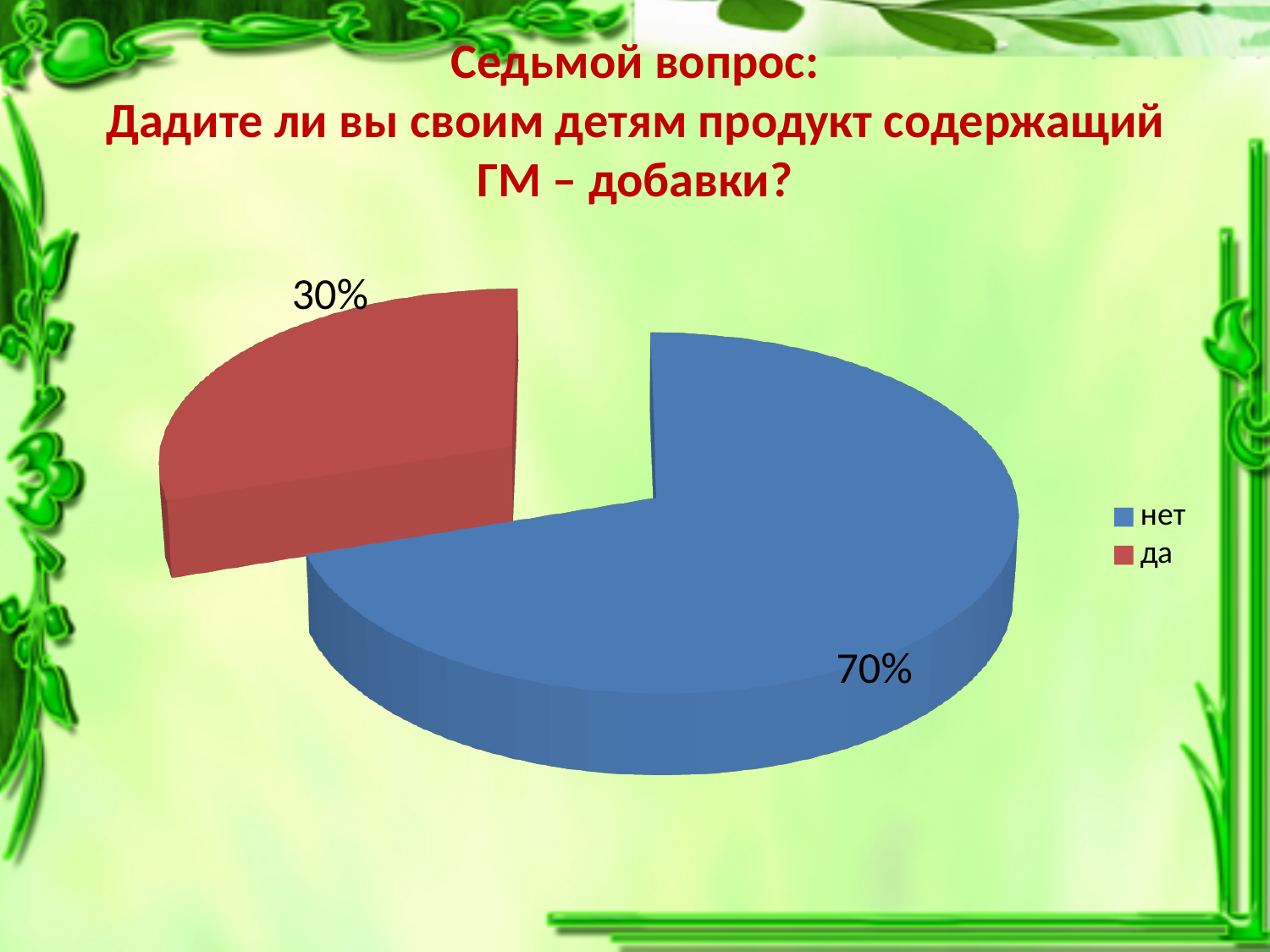
What colour is the slice for "нет"? blue What percentage is shown for "да"? 30% What colour is the slice for "да"? red Which is larger, the share for "да" or the share for "нет"? нет What percentage is shown for "нет"? 70% How many entries does the legend list? 2 What share of the pie does the "нет" slice represent? 70% What is the difference between the shares for "нет" and "да"? 40% How many slices does the pie chart have? 2 Which category has the smallest share of the pie? да What kind of chart is shown on the slide? pie chart Which category has the largest share of the pie? нет